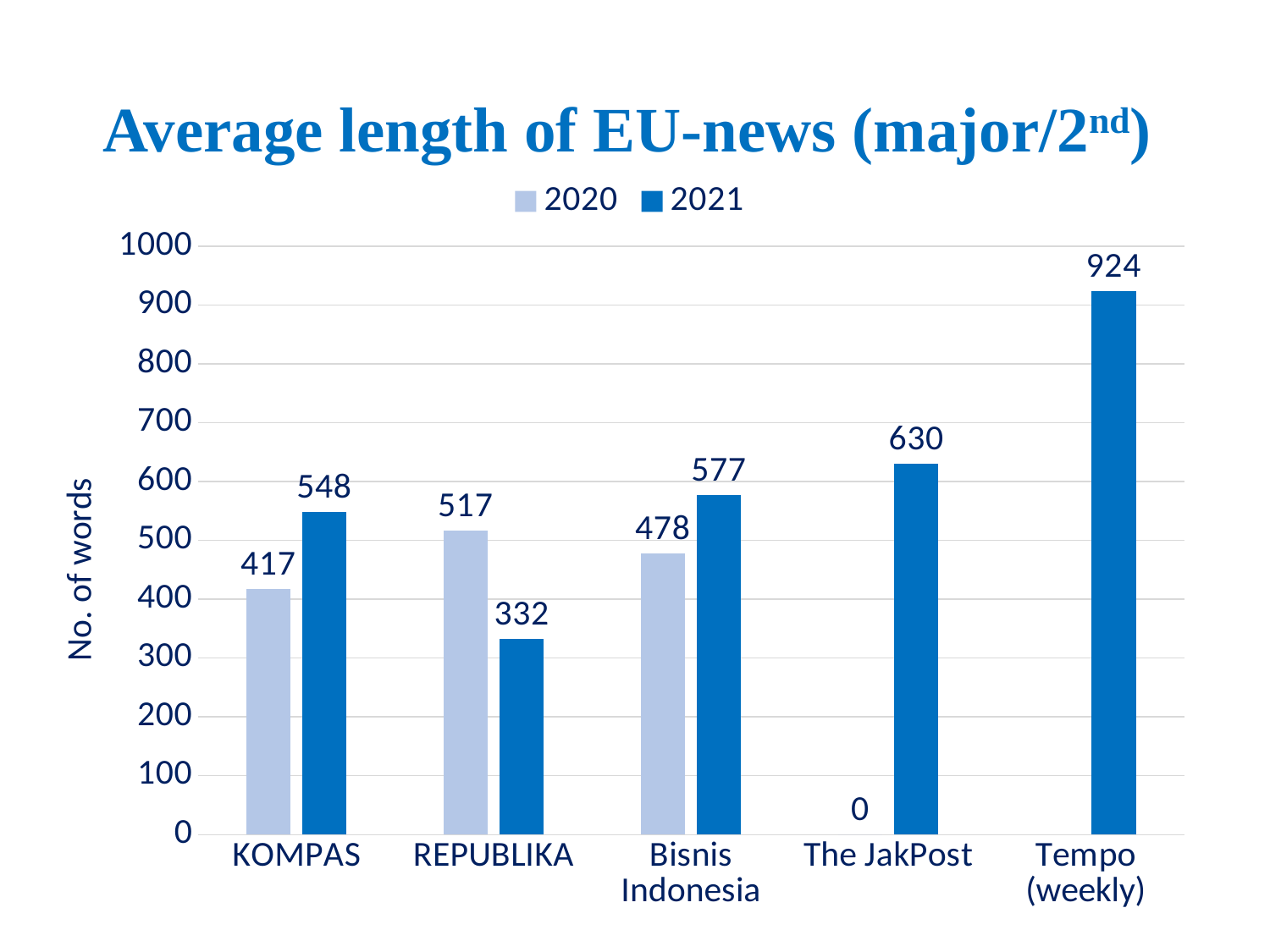
Which category has the highest 2021 value? Tempo (weekly) What kind of chart is shown on the slide? Bar chart Which category has the lowest 2021 value? REPUBLIKA What is the 2020 value for The JakPost? 0 What is the 2021 value for Tempo (weekly)? 924 What is the 2021 value for The JakPost? 630 How many categories are shown on the x axis? 5 For REPUBLIKA, which is larger: the 2020 value or the 2021 value? 2020 What is the 2020 value for REPUBLIKA? 517 How many series does the legend list? 2 What is the label of the vertical axis? No. of words What is the difference between the 2021 and 2020 values for KOMPAS? 131